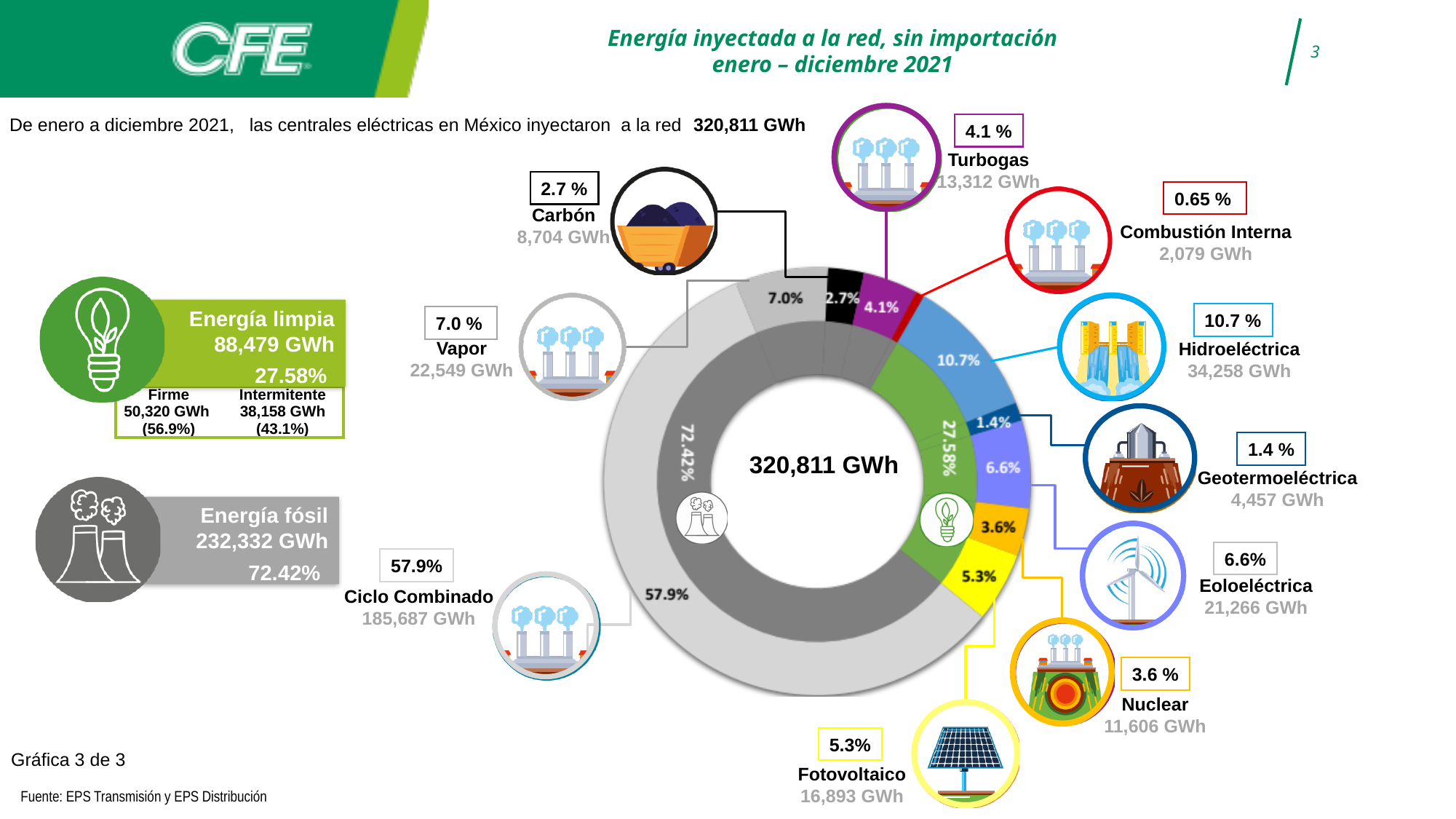
What kind of chart is shown on the slide? Pie chart (donut) What percentage is shown for Combustión Interna? 0.65 % What percentage of the energy injected is Energía limpia? 27.58% Which is larger, the share for Eoloeléctrica or the share for Fotovoltaico? Eoloeléctrica How many technology categories are shown in the outer ring of the donut chart? 10 What share of the energy injected does Ciclo Combinado represent? 57.9% How many GWh did Hidroeléctrica inject into the grid? 34,258 GWh Which technology has the largest share of the energy injected? Ciclo Combinado What is the difference between the Vapor share and the Carbón share? 4.3% What total value is printed in the centre of the donut chart? 320,811 GWh Which technology has the smallest share of the energy injected? Combustión Interna What is the difference in GWh between Energía fósil and Energía limpia? 143,853 GWh